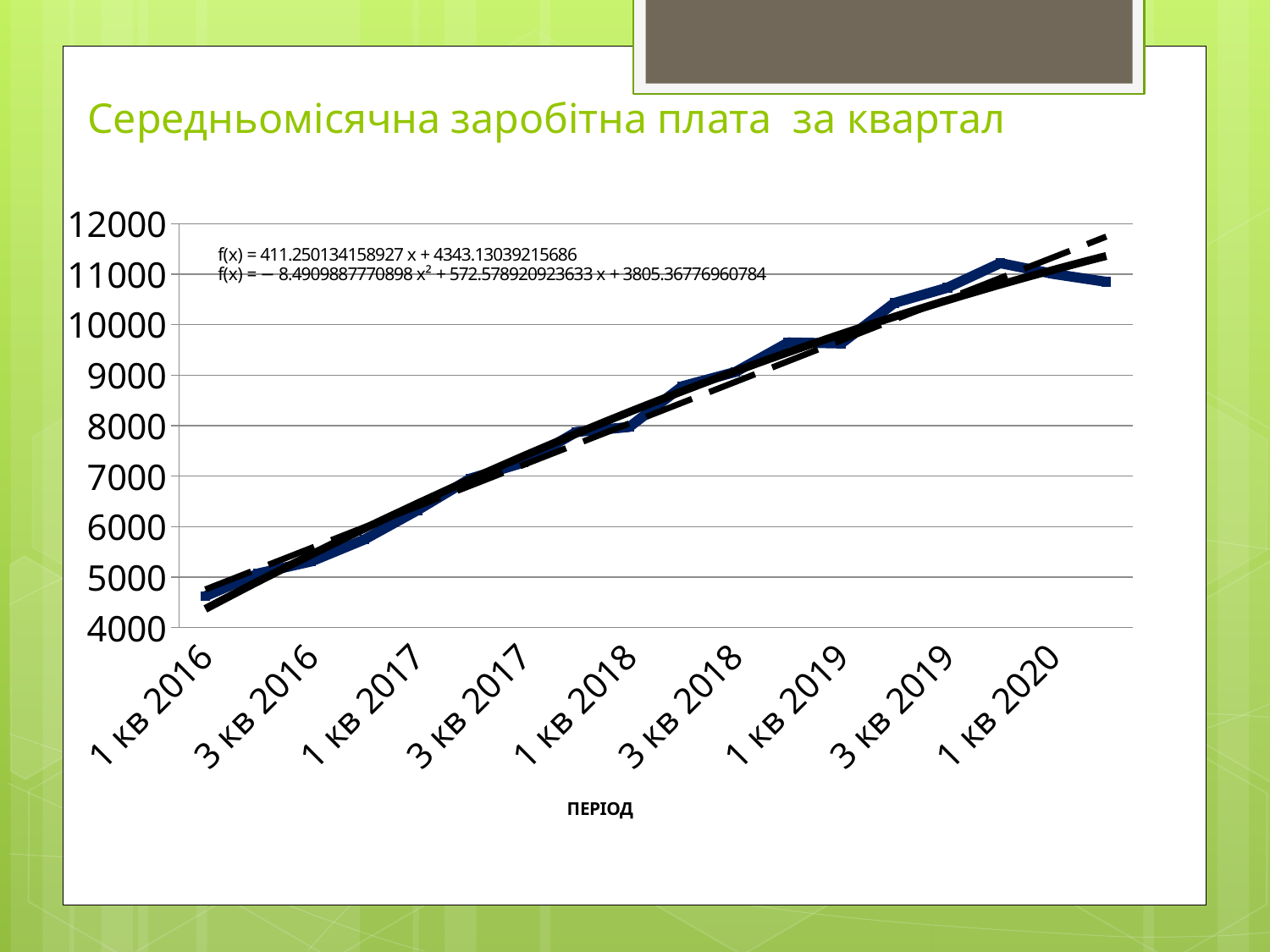
Which labeled period has the highest value? 1 кв 2020 What kind of chart is shown on the slide? line chart Which labeled period has the lowest value? 1 кв 2016 Is the value for 1 кв 2016 greater or less than 5000? less Is the value for 1 кв 2017 greater or less than 6000? greater What is the title of the x axis? ПЕРІОД How many period labels are shown on the x axis? 9 Is the value for 1 кв 2020 greater or less than 10000? greater Do the values generally rise or fall from 1 кв 2016 to 1 кв 2020? rise Which is larger, the value for 1 кв 2020 or the value for 1 кв 2016? 1 кв 2020 What is the title of the chart? Середньомісячна заробітна плата за квартал